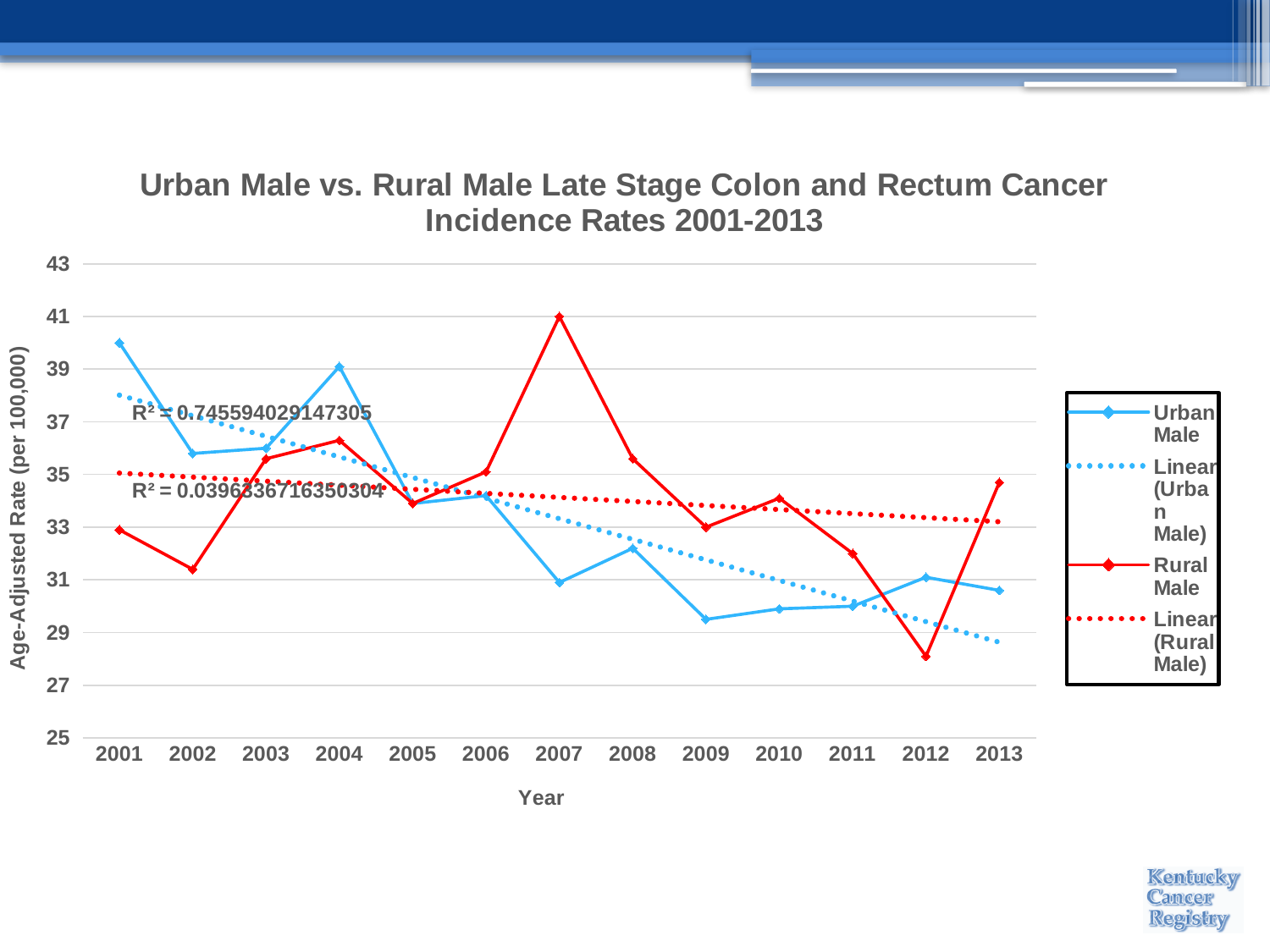
What R² value is shown for the Linear (Urban Male) trendline? 0.745594029147305 In which year is the Rural Male rate lowest? 2012 Is the Rural Male value for 2012 greater or less than 29? less In 2001, which series has the higher rate, Urban Male or Rural Male? Urban Male Is the Urban Male value for 2009 greater or less than 31? less Does the Urban Male series generally rise or fall from 2001 to 2013? Fall What kind of chart is shown on the slide? Line chart How many years are plotted along the x axis? 13 How many entries does the legend list? 4 In which year is the Rural Male rate highest? 2007 In which year is the Urban Male rate highest? 2001 Is the Rural Male value for 2007 greater or less than 39? greater